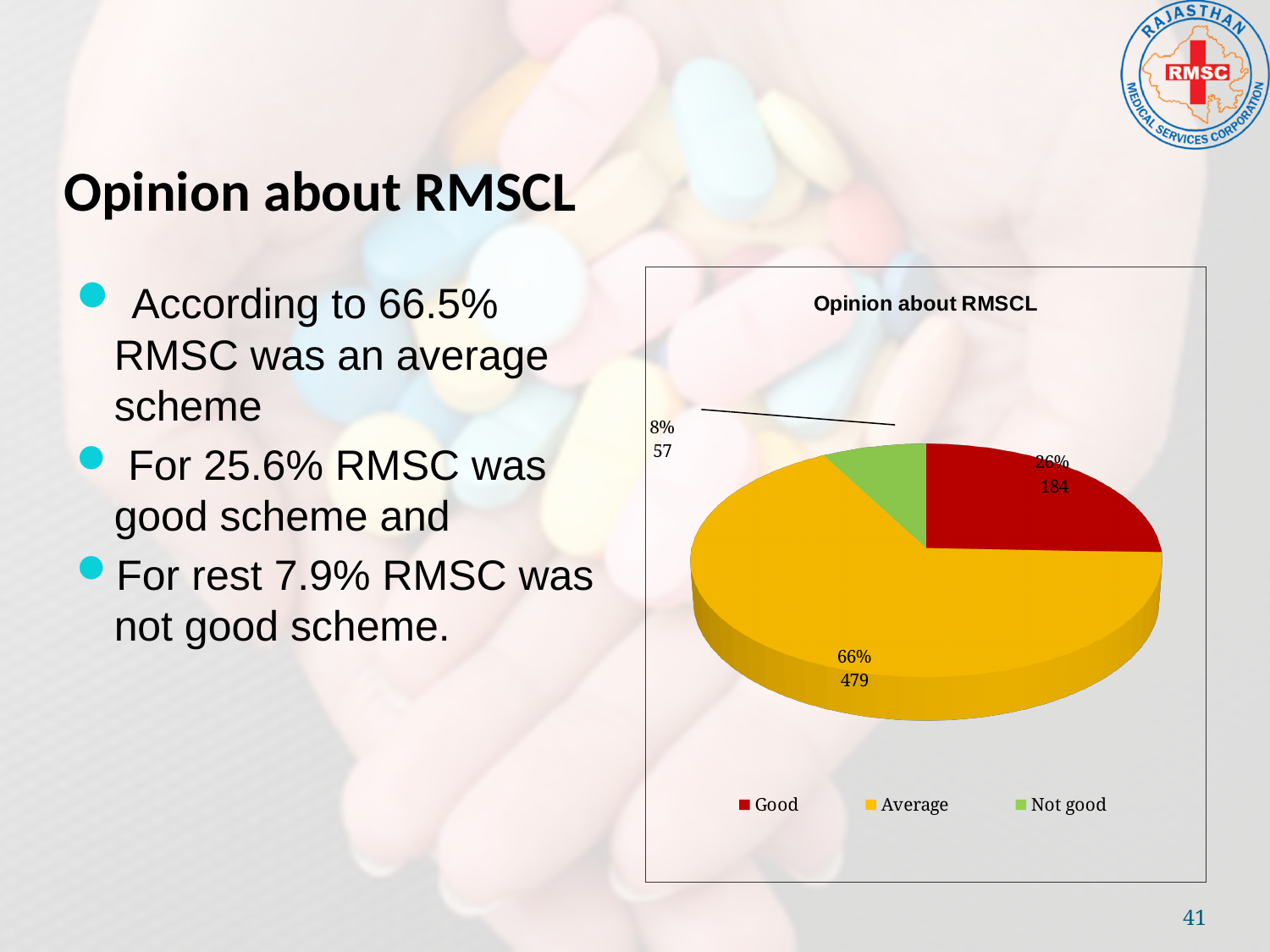
What is the title of the chart? Opinion about RMSCL What percentage share of the pie does the Average slice have? 66% Which colour represents the Good category in the chart? Red Which category has the smallest slice of the pie? Not good What count is shown for the Not good slice? 57 What percentage share of the pie does the Not good slice have? 8% Which category has the largest slice of the pie? Average What count is shown for the Average slice? 479 What type of chart is shown on the slide? Pie chart What count is shown for the Good slice? 184 What is the difference between the counts for Average and Good? 295 How many categories does the legend of the chart list? 3